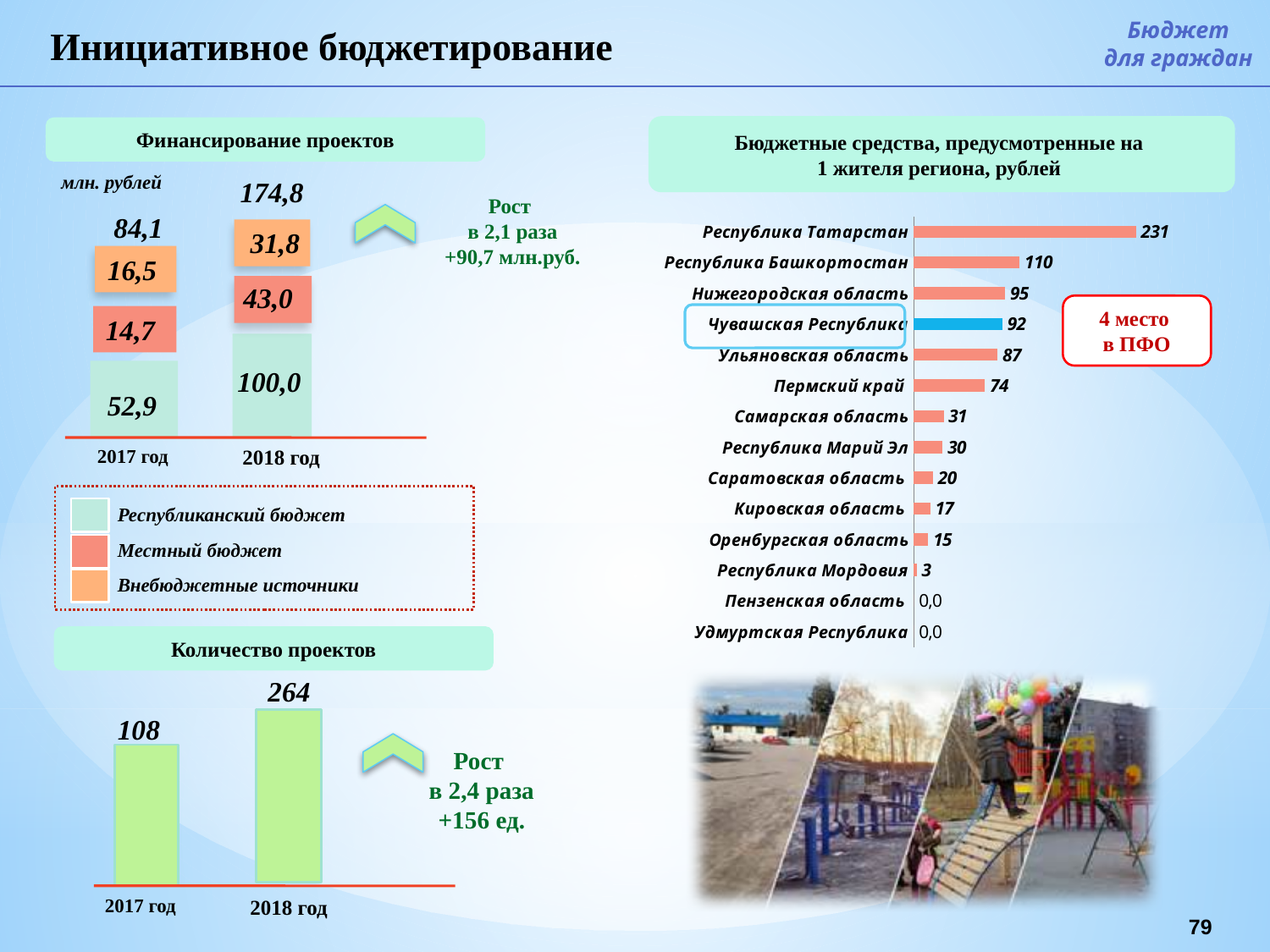
What kind of chart is 'Бюджетные средства, предусмотренные на 1 жителя региона, рублей'? Bar chart In the chart 'Бюджетные средства, предусмотренные на 1 жителя региона, рублей', which is larger: Ульяновская область or Пермский край? Ульяновская область How many series does the legend of the chart 'Финансирование проектов' list? 3 In the chart 'Бюджетные средства, предусмотренные на 1 жителя региона, рублей', which region has the highest value? Республика Татарстан In the chart 'Бюджетные средства, предусмотренные на 1 жителя региона, рублей', what is the value for Республика Татарстан? 231 In the chart 'Финансирование проектов', what is the total of the stacked bar for 2017 год? 84,1 In the chart 'Финансирование проектов', what is the value of Местный бюджет for 2018 год? 43,0 In the chart 'Бюджетные средства, предусмотренные на 1 жителя региона, рублей', what is the difference between Республика Татарстан and Республика Башкортостан? 121 In the chart 'Количество проектов', what is the difference between 2018 год and 2017 год? 156 In the chart 'Количество проектов', what is the value for 2018 год? 264 How many regions are listed in the chart 'Бюджетные средства, предусмотренные на 1 жителя региона, рублей'? 14 In the chart 'Бюджетные средства, предусмотренные на 1 жителя региона, рублей', what is the value for Чувашская Республика? 92